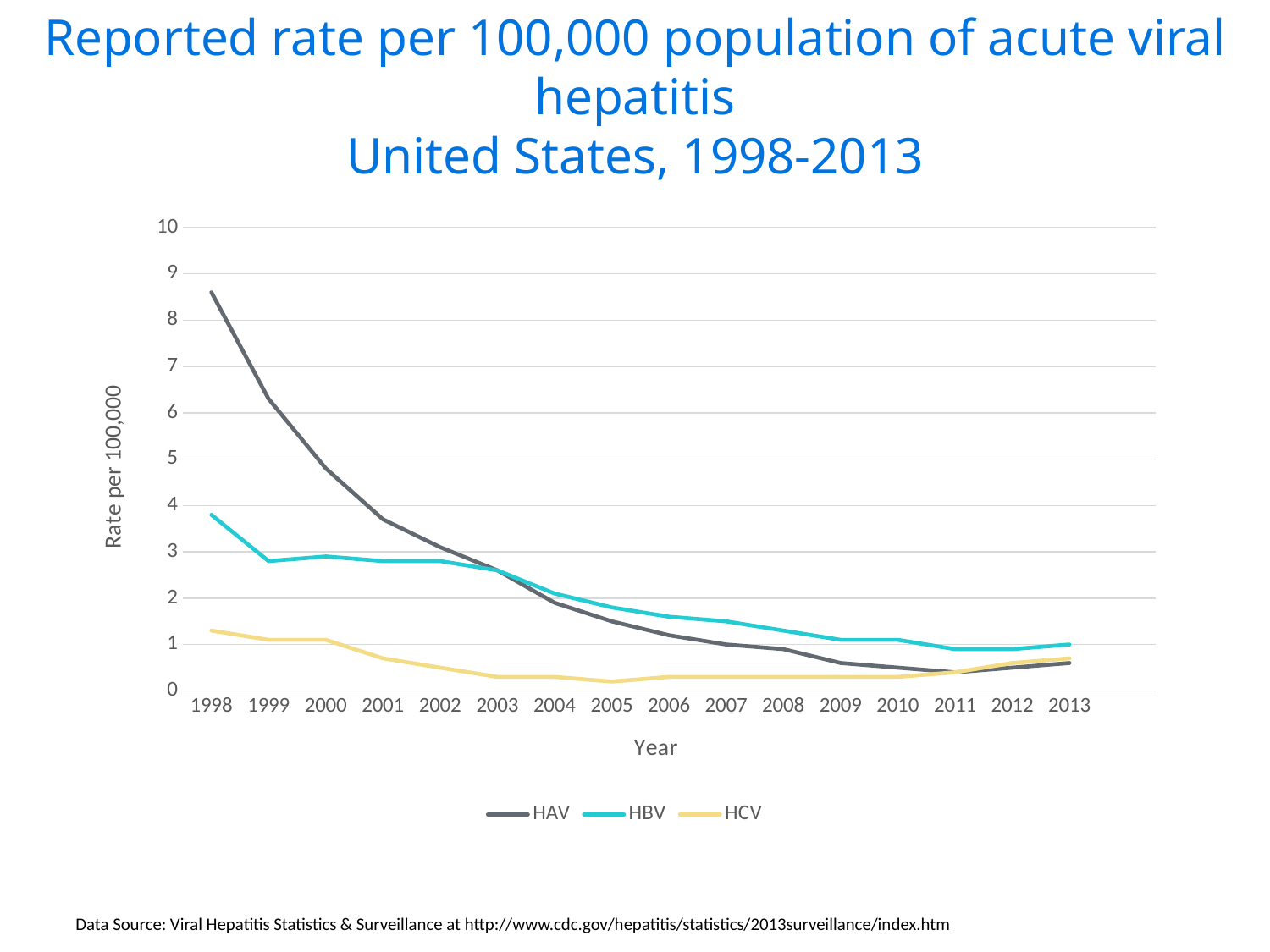
What kind of chart is shown on the slide? line chart Which is larger in 2008, the HAV rate or the HBV rate? HBV Is the HAV rate in 2013 greater or less than 1? less Which is larger in 2000, the HBV rate or the HCV rate? HBV Does the HAV rate rise or fall from 1998 to 2013? fall Is the HCV rate in 1998 greater or less than 1? greater How many years are plotted along the x axis? 16 Is the HAV rate in 1998 greater or less than 8? greater Which series has the lowest rate in 2005? HCV Which series has the highest rate in 1998? HAV What is the label of the y axis? Rate per 100,000 How many series does the legend list? 3